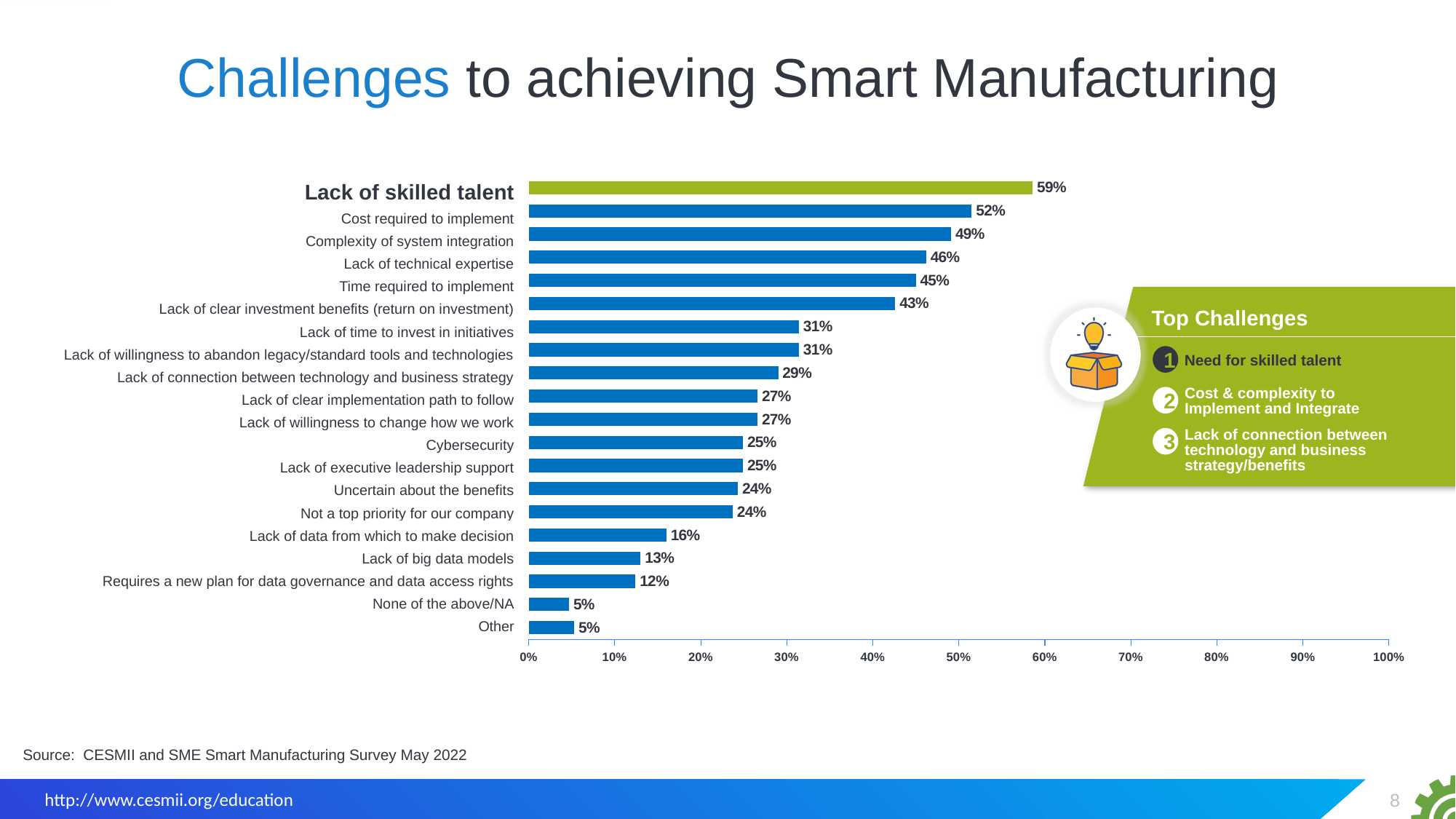
What is the difference between Lack of technical expertise and Lack of data from which to make decision? 30% Which is larger, Time required to implement or Lack of time to invest in initiatives? Time required to implement Which bar is coloured green rather than blue? Lack of skilled talent What is the value for Lack of skilled talent? 59% What is the value for Lack of connection between technology and business strategy? 29% Is the value for Complexity of system integration greater or less than 40%? greater How many categories are shown in the chart? 20 What is the difference between Lack of skilled talent and Cost required to implement? 7% What kind of chart is shown on the slide? Bar chart Which category has the highest value? Lack of skilled talent What is the value for Cybersecurity? 25% What is the value for Lack of big data models? 13%